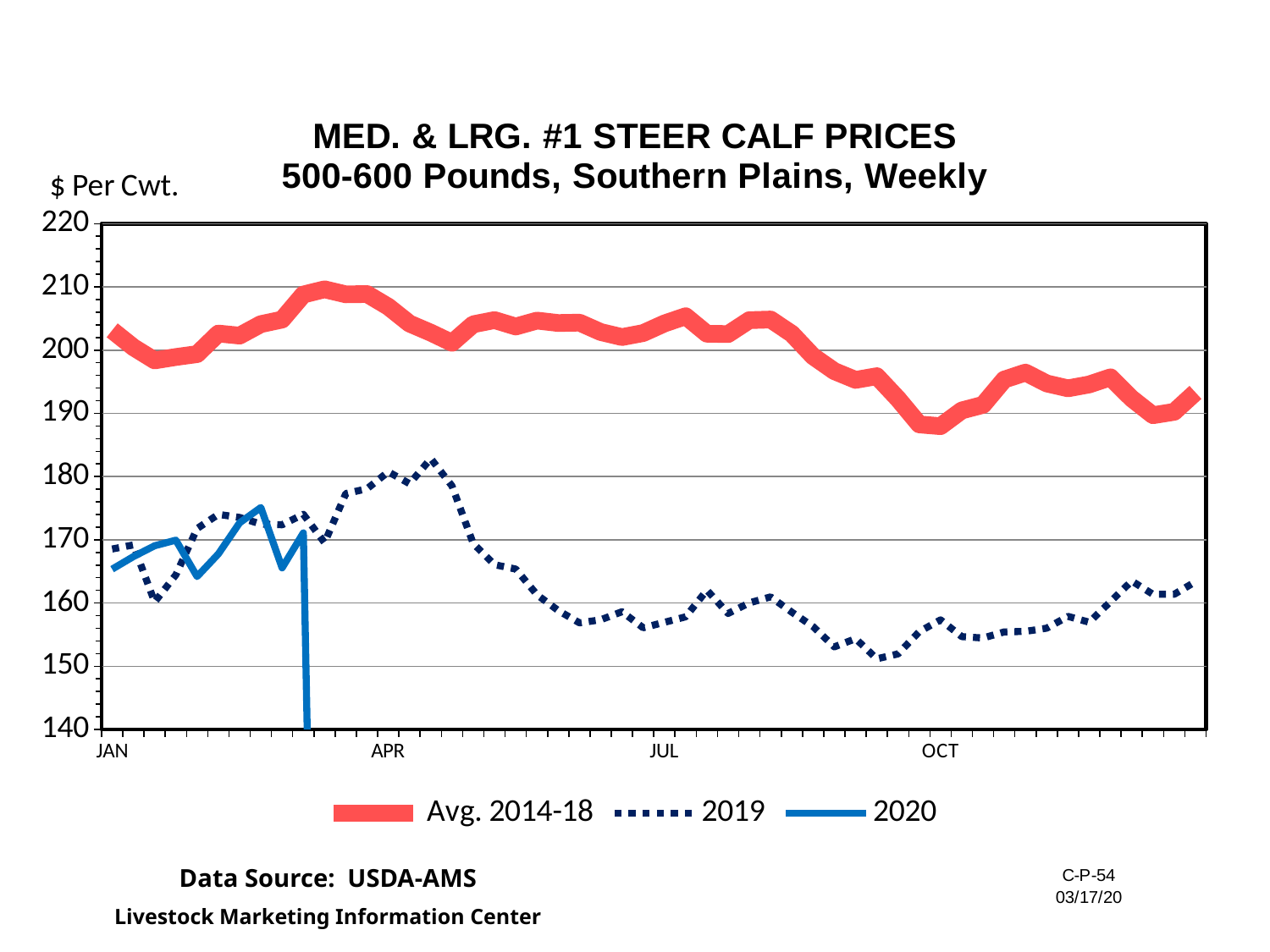
Is the value of the 2019 series at APR greater or less than 170? greater What are the three series listed in the legend? Avg. 2014-18, 2019, 2020 Which series has the highest values across the year? Avg. 2014-18 Does the 2019 series rise or fall between APR and JUL? fall Is the value of the 2020 series at JAN greater or less than 160? greater Is the value of the Avg. 2014-18 series at OCT greater or less than 200? less How many series does the legend list? 3 At JUL, which series has the higher value: Avg. 2014-18 or 2019? Avg. 2014-18 What unit is shown on the y axis label? $ Per Cwt. What kind of chart is shown on the slide? line chart